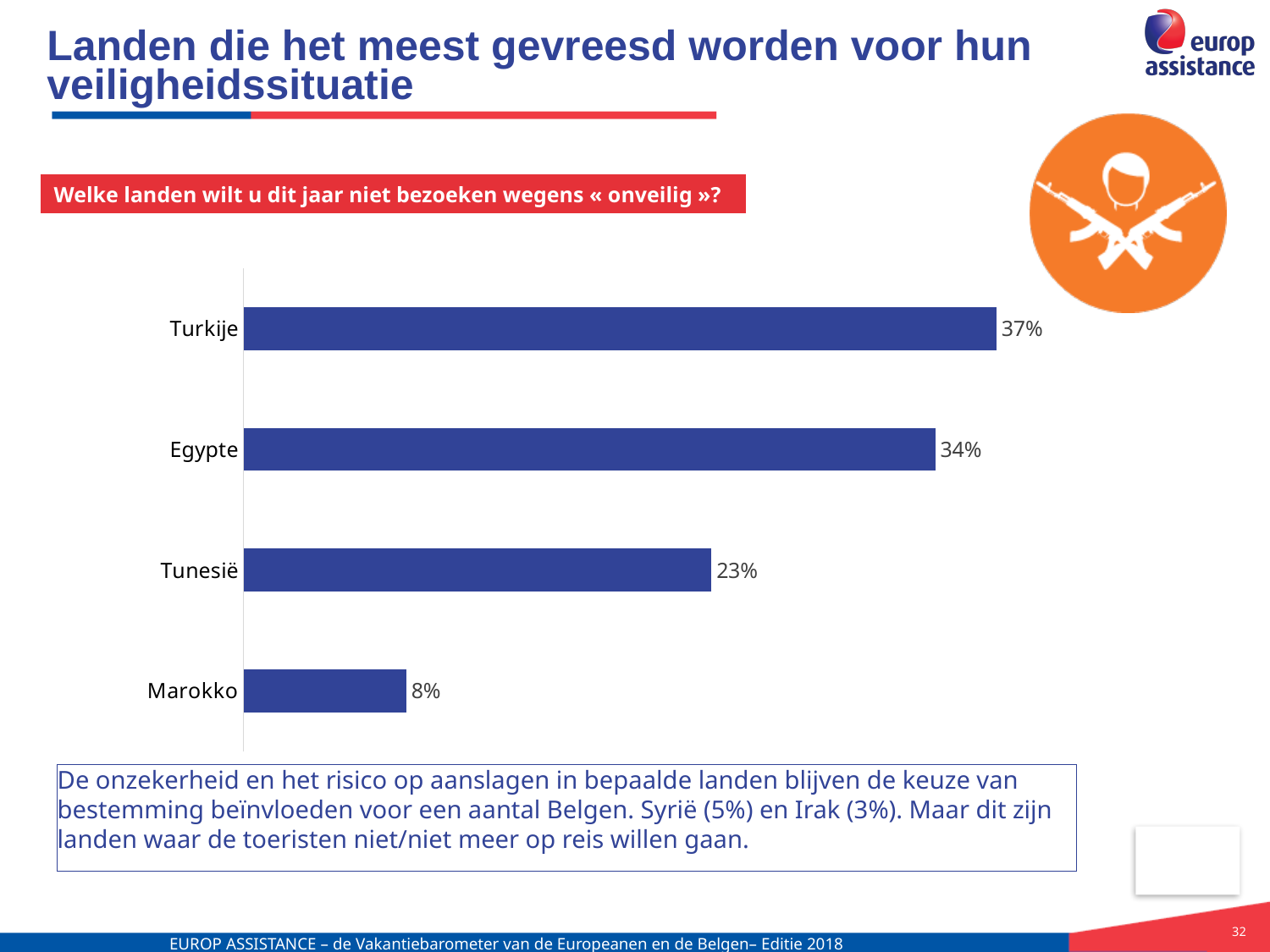
What is the value for Egypte? 34% What is the value for Turkije? 37% What question is shown in the box above the chart? Welke landen wilt u dit jaar niet bezoeken wegens « onveilig »? How many countries are shown in the chart? 4 What is the difference between the values for Tunesië and Marokko? 15% What kind of chart is shown on the slide? bar chart Which is larger, the value for Egypte or the value for Tunesië? Egypte Which country has the lowest value? Marokko What is the difference between the values for Turkije and Egypte? 3% Which country has the highest value? Turkije What is the value for Marokko? 8% What is the value for Tunesië? 23%